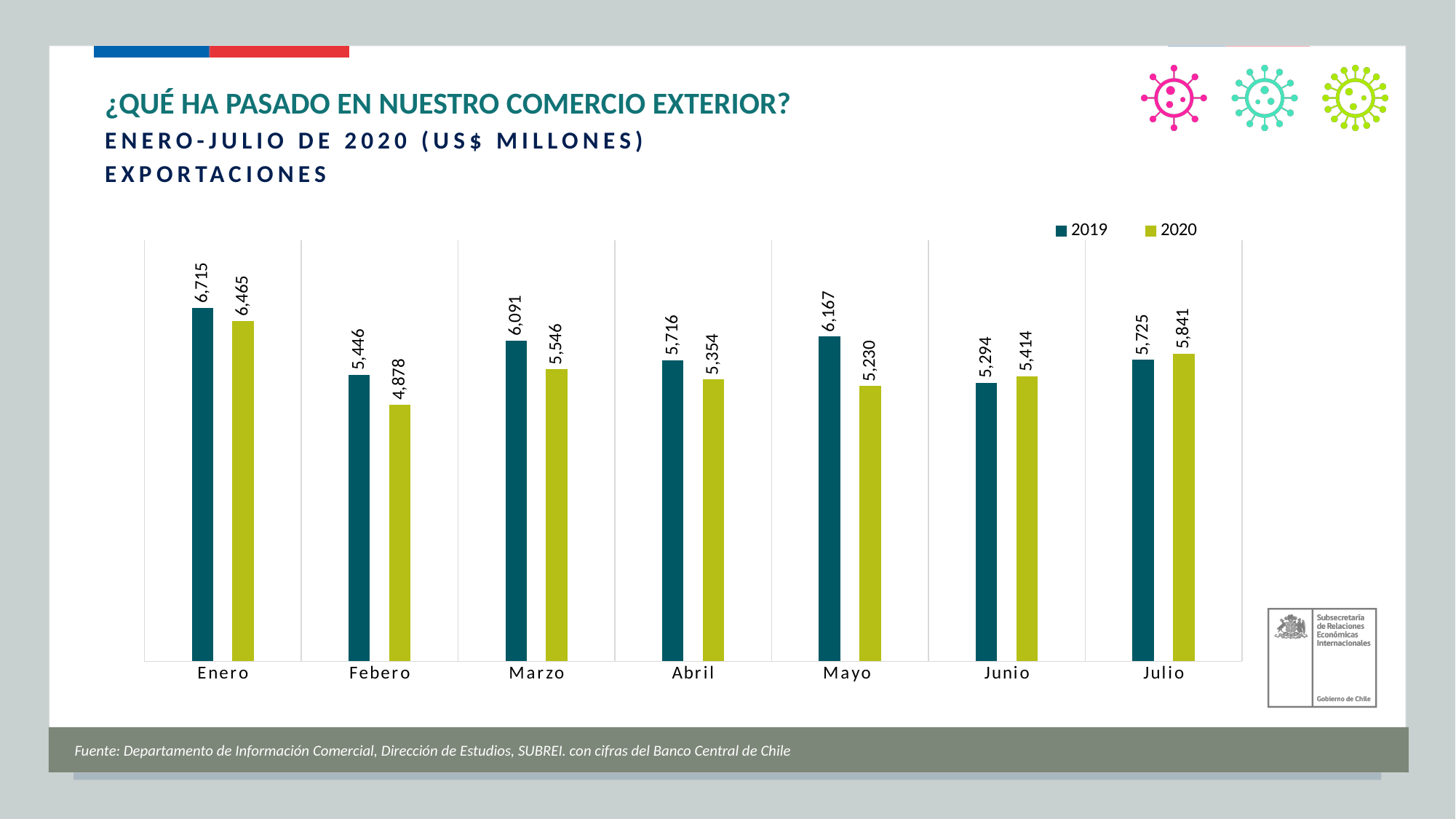
Which series is shown in the dark teal colour? 2019 Which is larger, the 2019 or the 2020 export value for Junio? 2020 How many series does the legend list? 2 What was the value of exports in Mayo 2019? 6,167 What was the value of exports in Enero 2019? 6,715 What is the difference between the 2019 and 2020 export values for Mayo? 937 What kind of chart is shown on the slide? Bar chart Which month has the highest 2020 export value? Enero What was the value of exports in Julio 2020? 5,841 What was the value of exports in Febero 2020? 4,878 How many months are shown on the x axis? 7 Which month has the lowest 2019 export value? Junio